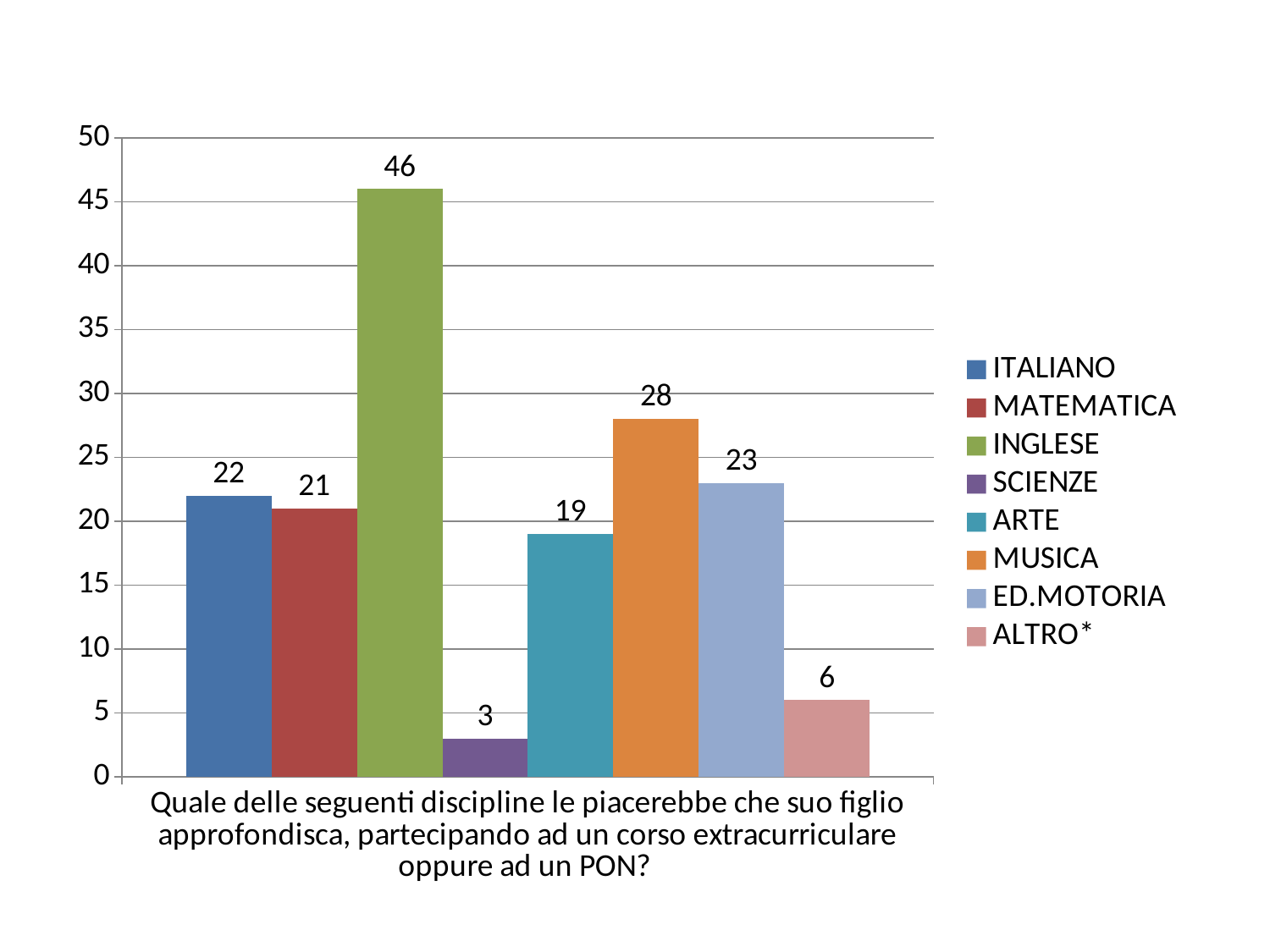
Which series has the highest value? INGLESE What is the value for INGLESE? 46 What is the value for ED.MOTORIA? 23 What is the difference between the values for INGLESE and MUSICA? 18 Which series has the lowest value? SCIENZE What is the difference between the values for ITALIANO and ARTE? 3 What kind of chart is shown on the slide? bar chart What is the value for MUSICA? 28 Which is larger, the value for MUSICA or the value for ED.MOTORIA? MUSICA How many series does the legend list? 8 What colour is the bar for ALTRO*? pink What is the value for SCIENZE? 3